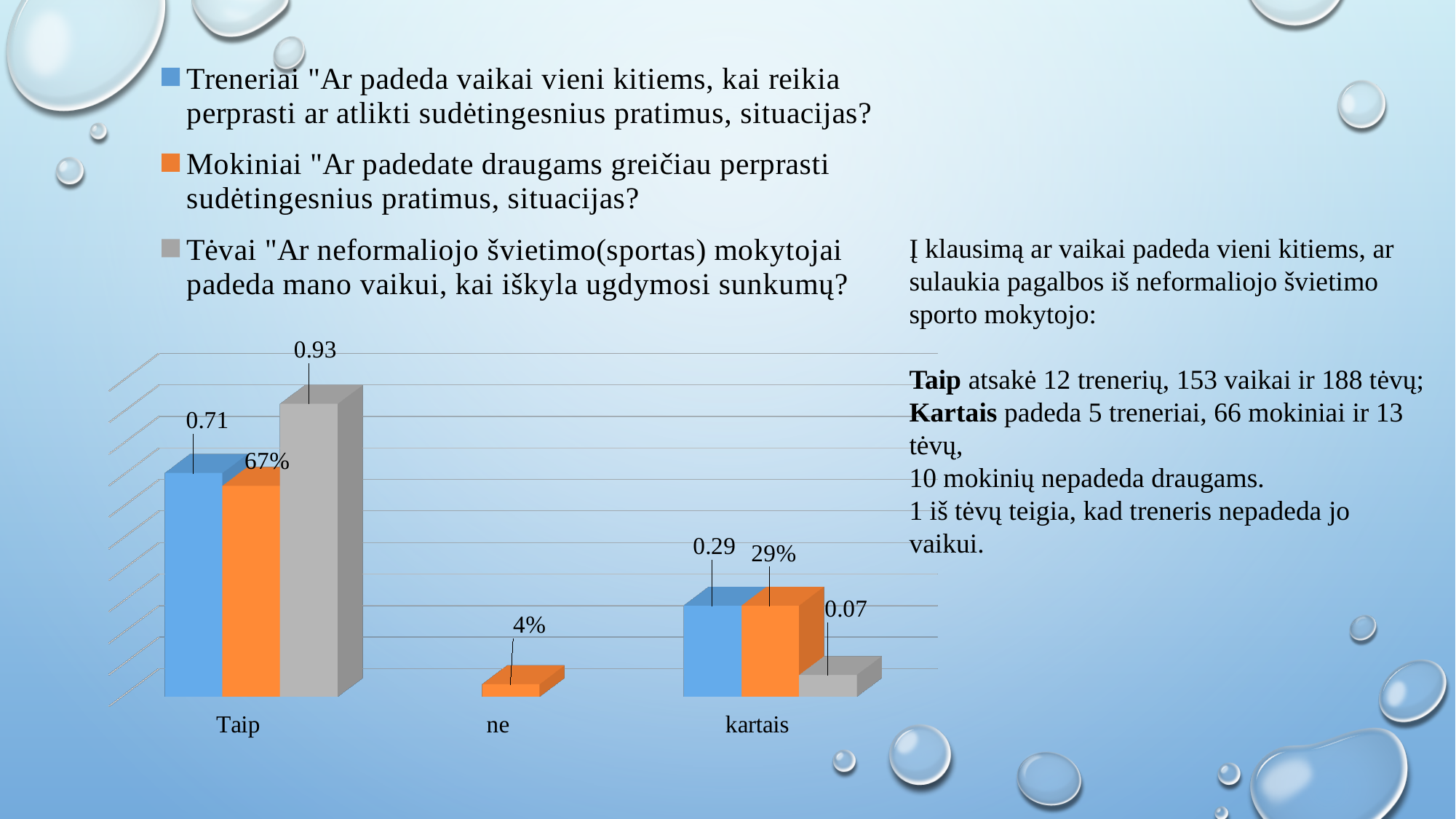
For the Treneriai series, which is larger: the value for Taip or the value for kartais? Taip What is the value of the Tėvai series for the category Taip? 0.93 How many categories are shown on the x axis of the chart? 3 What is the value of the Treneriai series for the category Taip? 0.71 What is the value of the Treneriai series for the category kartais? 0.29 How many series does the legend list? 3 What is the value of the Mokiniai series for the category ne? 4% For the Tėvai series, which category has the highest value? Taip For the Mokiniai series, which category has the lowest value? ne What is the value of the Tėvai series for the category kartais? 0.07 What is the value of the Mokiniai series for the category Taip? 67% What is the difference between the Tėvai values for Taip and kartais? 0.86